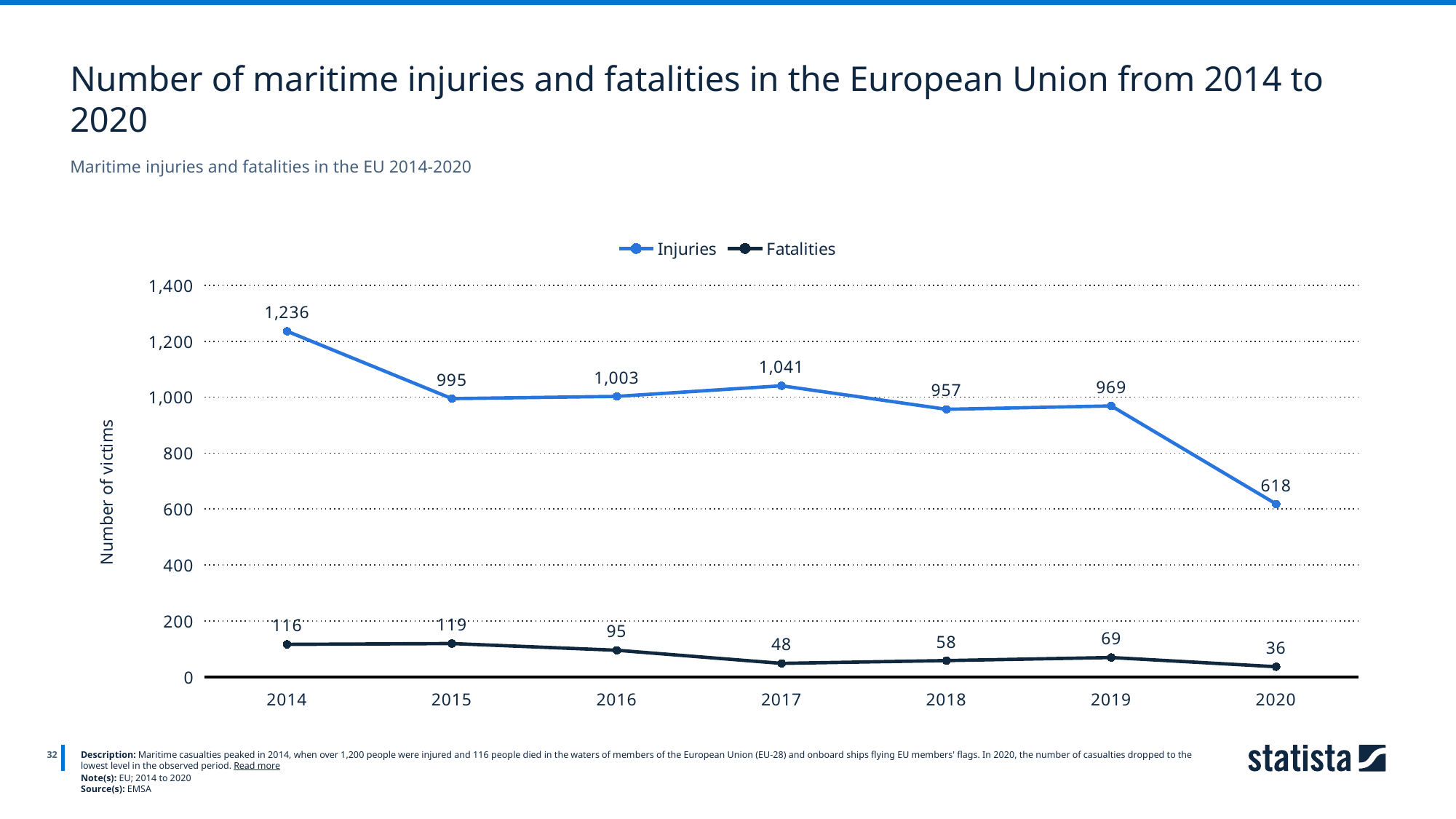
How many series does the legend list? 2 What is the label of the y axis? Number of victims Is the number of injuries in 2019 greater or less than 800? greater How many years are shown on the x axis? 7 How many maritime fatalities were recorded in the EU in 2017? 48 What is the difference between the number of injuries in 2017 and in 2018? 84 Which year had more fatalities, 2015 or 2019? 2015 What kind of chart is shown on the slide? Line chart What was the number of maritime injuries in the EU in 2014? 1,236 In which year were maritime fatalities lowest? 2020 In which year were maritime injuries highest? 2014 What was the number of injuries in 2020? 618